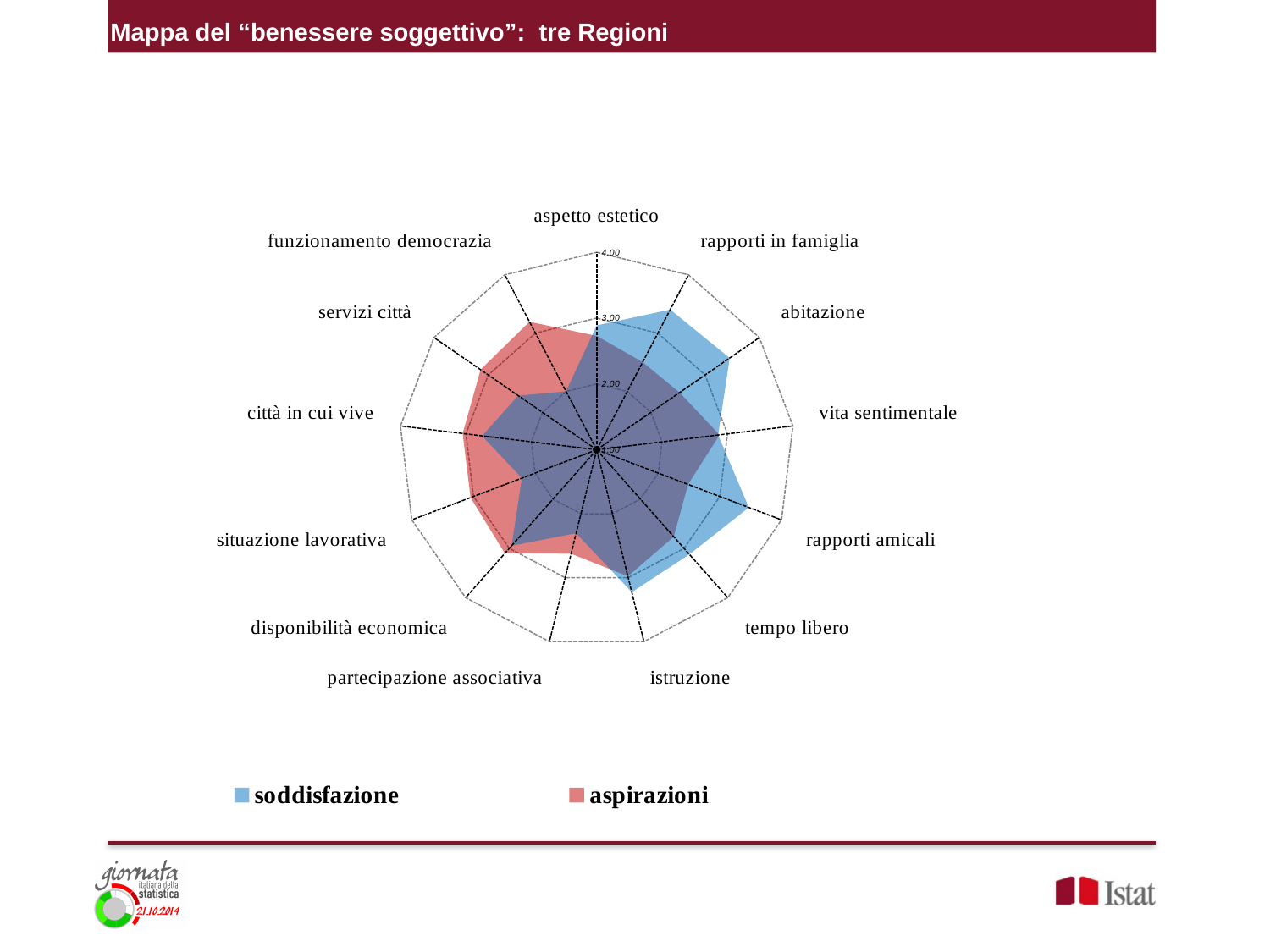
Is the soddisfazione value for vita sentimentale greater or less than 2.00? greater Is the aspirazioni value for situazione lavorativa greater or less than 2.00? greater Is the soddisfazione value for rapporti amicali greater or less than 2.00? greater Which series is shown in blue? soddisfazione What kind of chart is shown on the slide? radar chart What is the title of the slide? Mappa del "benessere soggettivo": tre Regioni How many categories (axes) does the radar chart have? 13 For città in cui vive, which series has the larger value, soddisfazione or aspirazioni? aspirazioni How many series does the legend list? 2 For situazione lavorativa, which series has the larger value, soddisfazione or aspirazioni? aspirazioni For abitazione, which series has the larger value, soddisfazione or aspirazioni? soddisfazione